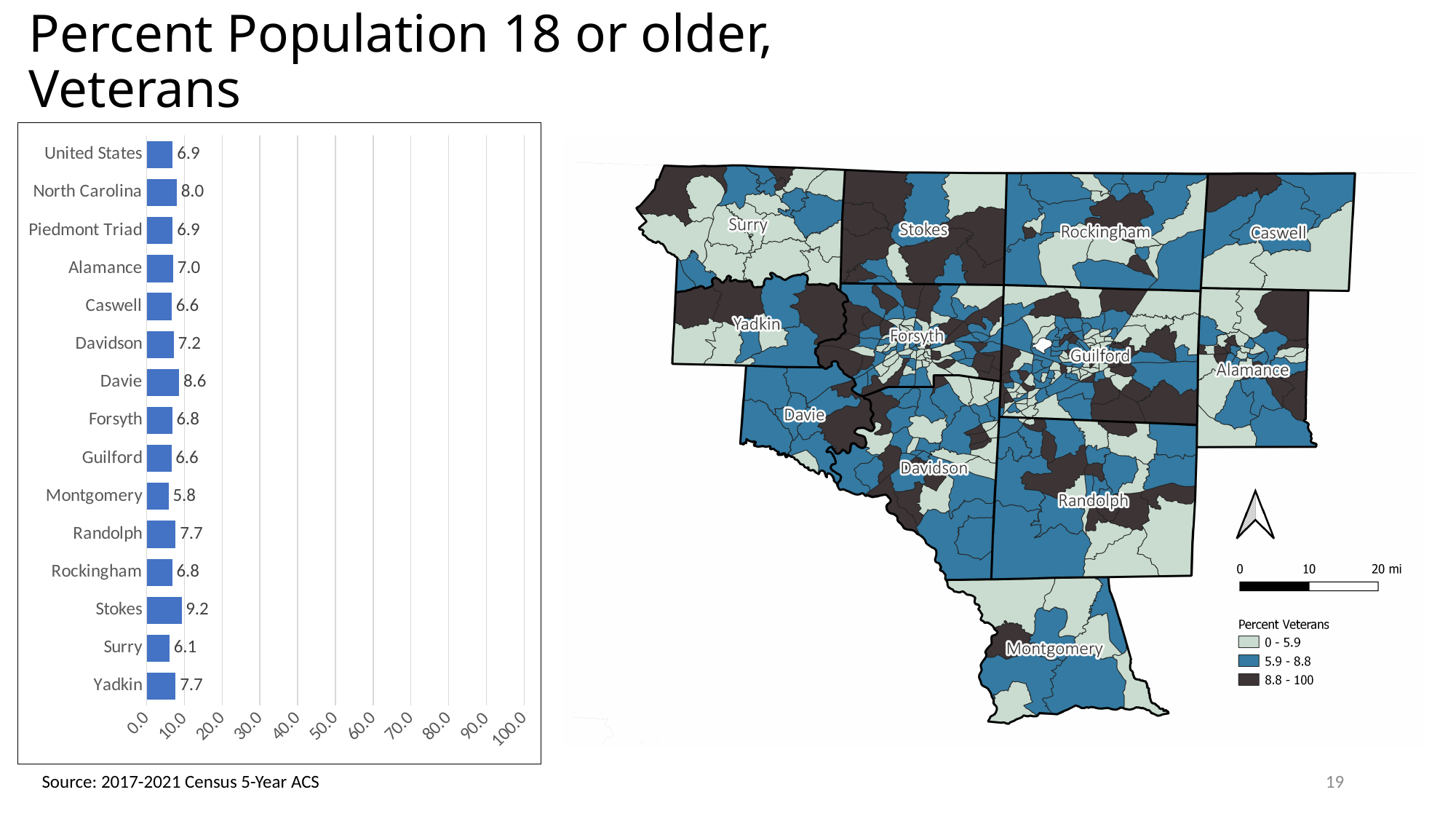
Is the value for Stokes in the bar chart greater or less than 10.0? less What is the value for Montgomery in the bar chart? 5.8 What is the difference between the values for Stokes and Montgomery in the bar chart? 3.4 What is the difference between the values for North Carolina and the United States in the bar chart? 1.1 How many categories are shown in the bar chart? 15 What is the value for Davie in the bar chart? 8.6 Which category has the lowest value in the bar chart? Montgomery Which has a larger value in the bar chart, Davie or Davidson? Davie What is the highest value shown on the x axis of the bar chart? 100.0 Which category has the highest value in the bar chart? Stokes What kind of chart is shown on the left of the slide? bar chart What is the value for North Carolina in the bar chart? 8.0